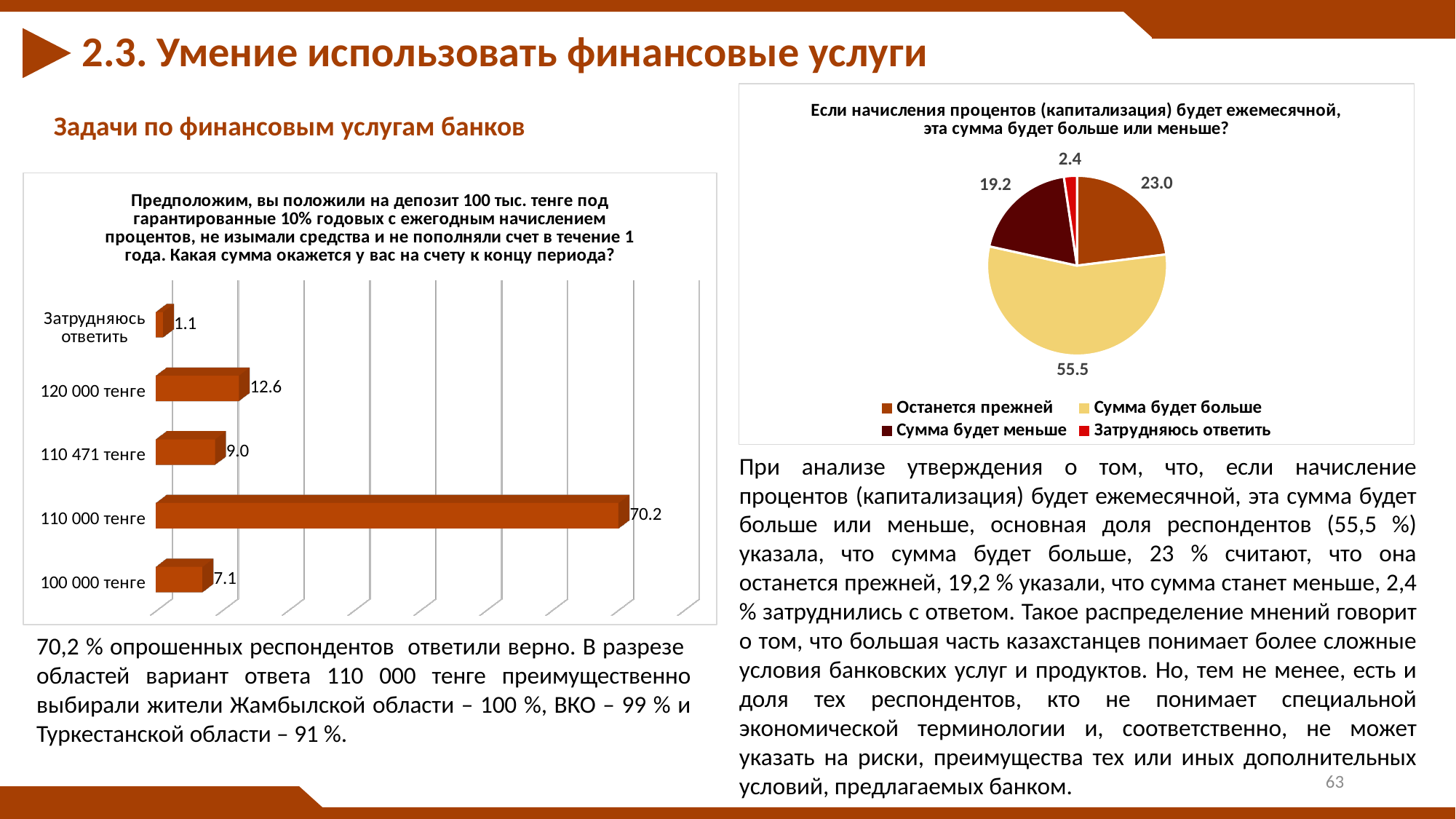
In the bar chart on the left, which is larger: the value for "100 000 тенге" or the value for "110 471 тенге"? 110 471 тенге In the bar chart on the left, what is the difference between the values for "120 000 тенге" and "110 471 тенге"? 3.6 In the bar chart on the left, what is the value for "120 000 тенге"? 12.6 What type of chart is the chart on the left of the slide? Bar chart In the bar chart on the left, which category has the highest value? 110 000 тенге In the bar chart on the left, which category has the lowest value? Затрудняюсь ответить In the pie chart on the right, what is the value for "Сумма будет меньше"? 19.2 In the pie chart on the right, what is the value for "Сумма будет больше"? 55.5 In the bar chart on the left, what is the value for "110 000 тенге"? 70.2 In the pie chart on the right, which category has the smallest slice? Затрудняюсь ответить How many entries does the legend of the pie chart on the right list? 4 How many categories does the bar chart on the left show? 5